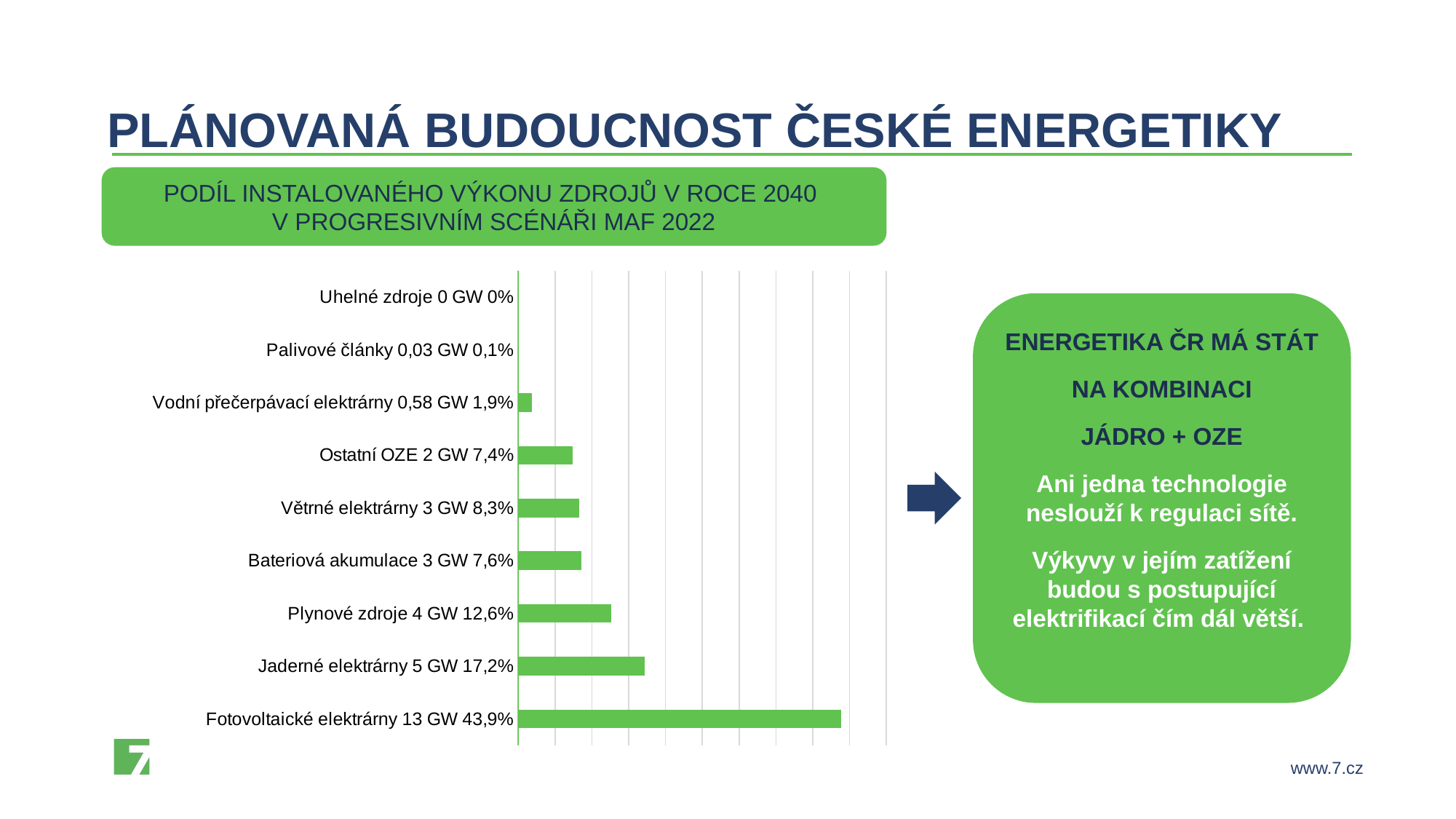
What installed capacity is shown for Vodní přečerpávací elektrárny? 0,58 GW What share is shown for Palivové články? 0,1% Which category has the highest installed capacity in the chart? Fotovoltaické elektrárny How many categories does the chart show? 9 What is the difference in installed capacity between Fotovoltaické elektrárny and Jaderné elektrárny? 8 GW What share is shown for Plynové zdroje? 12,6% What is the title shown in the green box above the chart? PODÍL INSTALOVANÉHO VÝKONU ZDROJŮ V ROCE 2040 V PROGRESIVNÍM SCÉNÁŘI MAF 2022 What share is shown for Fotovoltaické elektrárny? 43,9% Which has a larger share, Větrné elektrárny or Ostatní OZE? Větrné elektrárny What installed capacity is shown for Jaderné elektrárny? 5 GW What kind of chart is shown on the slide? bar chart Which category has the lowest installed capacity in the chart? Uhelné zdroje